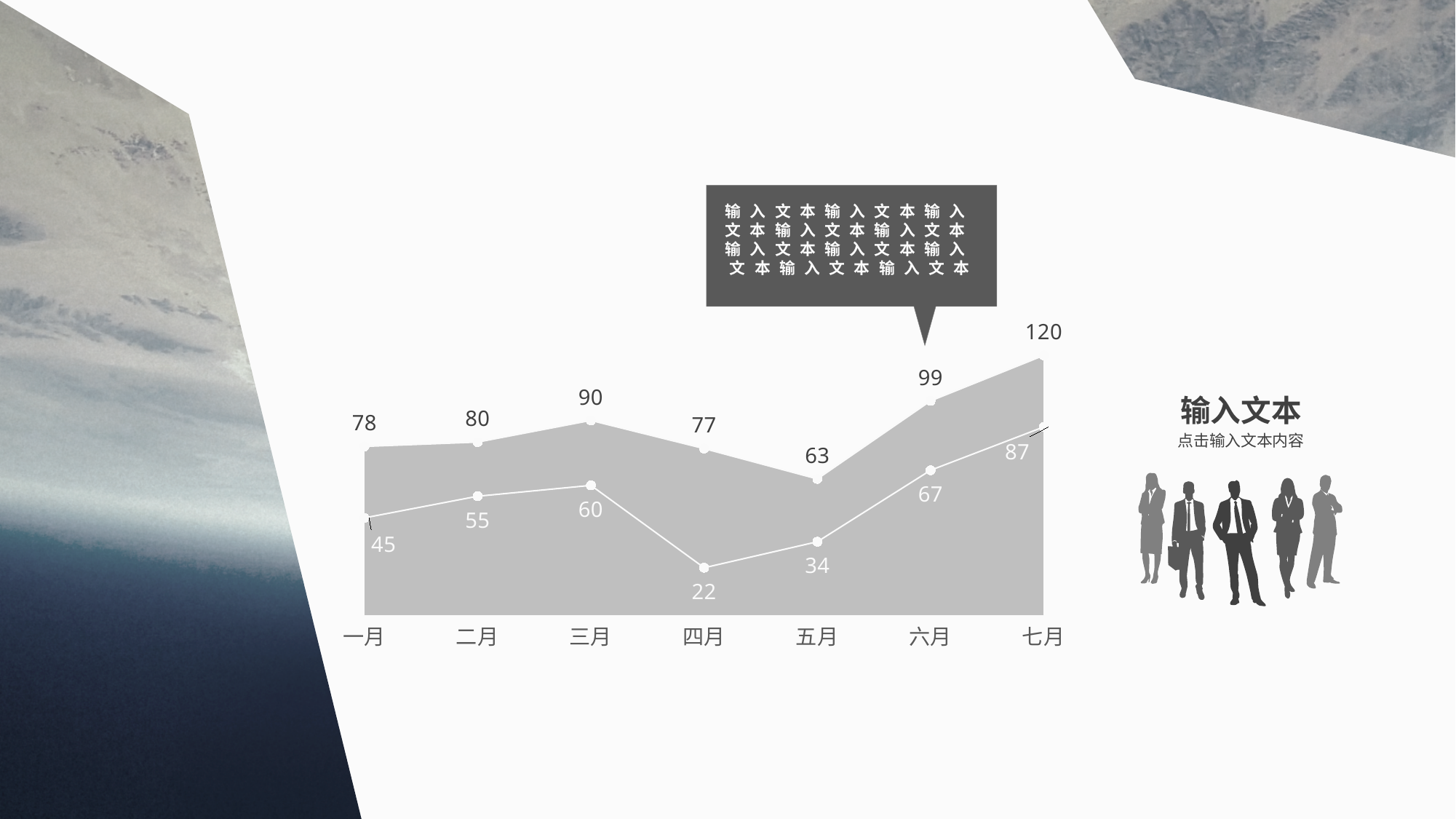
What is the difference between the grey area series values for 七月 and 六月? 21 In which month does the grey area series reach its highest value? 七月 In which month does the grey area series have its lowest value? 五月 How many months are shown on the x axis of the chart? 7 What is the value of the white line series for 四月? 22 Which month has the larger grey area series value, 二月 or 四月? 二月 In which month does the white line series have its lowest value? 四月 What is the value of the grey area series for 五月? 63 Does the white line series rise or fall from 四月 to 七月? rise What is the value of the grey area series for 三月? 90 In 七月, how much higher is the grey area series value than the white line series value? 33 What is the value of the white line series for 六月? 67